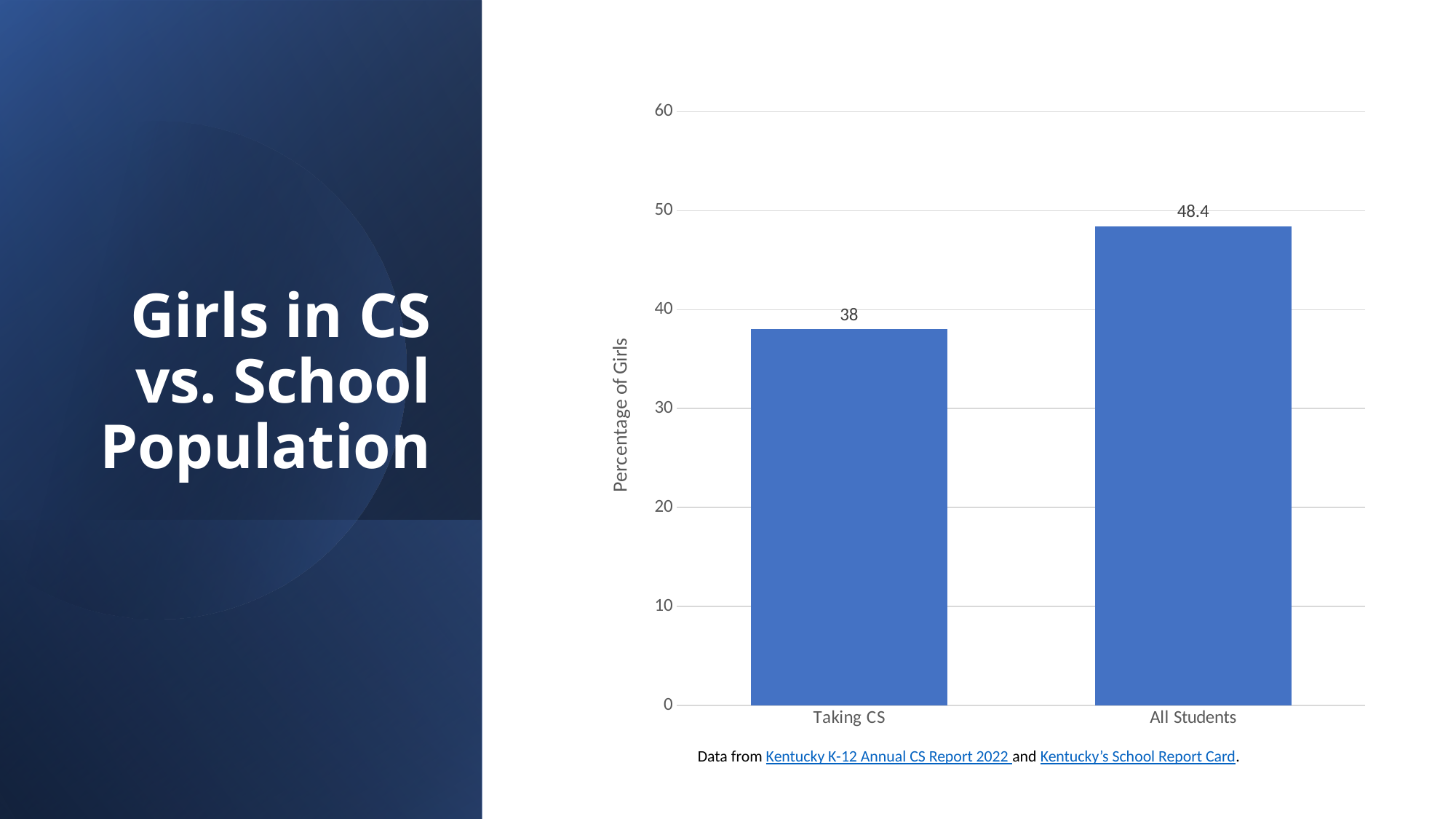
What kind of chart is shown on the slide? bar chart Is the value for Taking CS greater or less than 40? less Is the value for Taking CS larger or smaller than the value for All Students? smaller What is the percentage of girls for All Students? 48.4 Which category has the higher percentage of girls? All Students What is the percentage of girls for Taking CS? 38 How many categories are shown on the x axis? 2 What is the label of the vertical axis? Percentage of Girls What is the title of the slide containing the chart? Girls in CS vs. School Population Which category has the lower percentage of girls? Taking CS Is the value for All Students greater or less than 50? less What is the difference between the percentage of girls for All Students and for Taking CS? 10.4